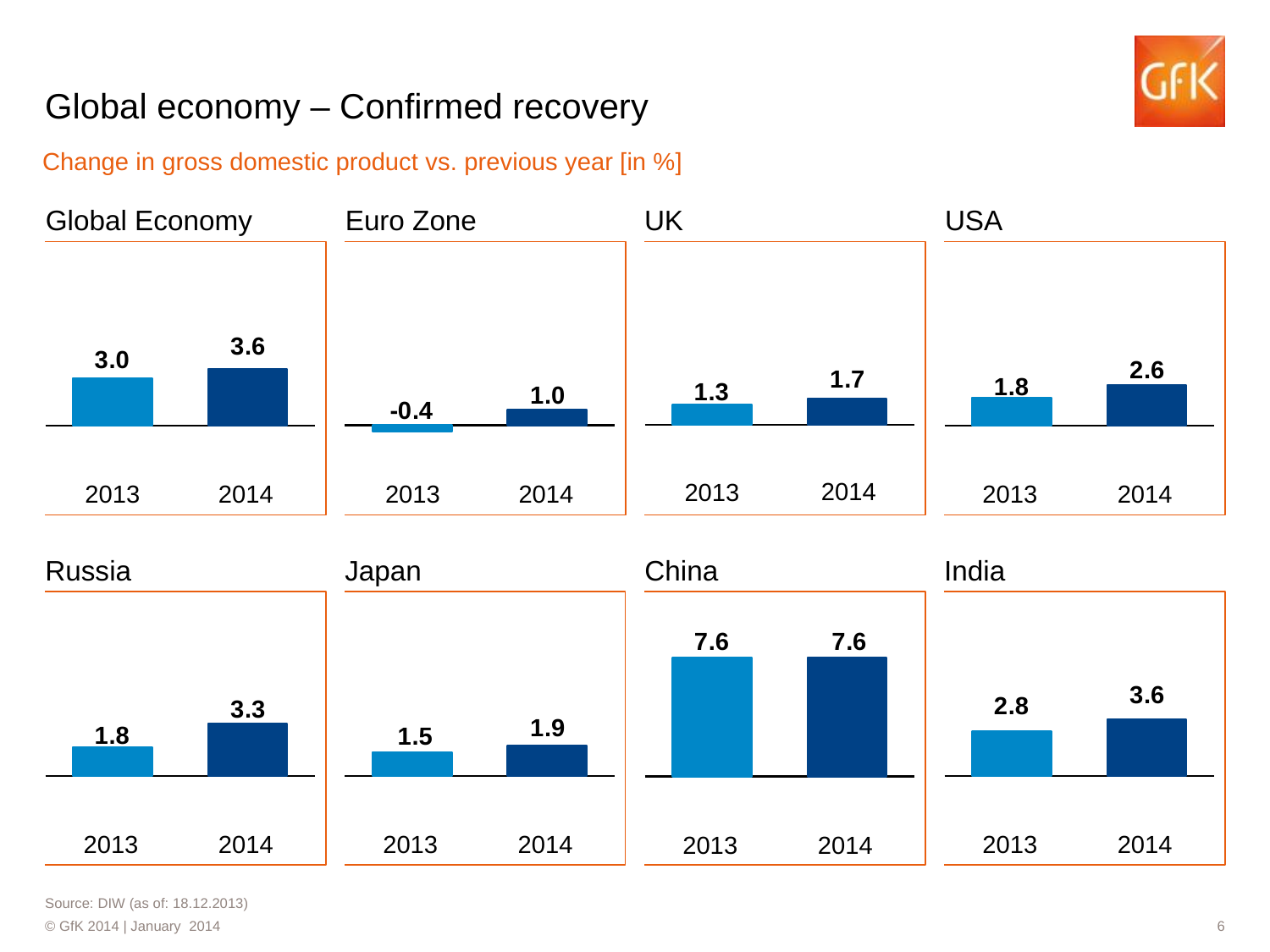
In the Euro Zone chart, do the values rise or fall from 2013 to 2014? rise What kind of chart is the China chart? bar chart What is the subtitle describing the measure shown in the charts? Change in gross domestic product vs. previous year [in %] In the India chart, what is the difference between the 2014 and 2013 values? 0.8 In the USA chart, what is the difference between the 2014 and 2013 values? 0.8 In the Global Economy chart, what is the value for 2014? 3.6 How many bars are shown in the Russia chart? 2 In the Russia chart, which year has the higher value? 2014 In the China chart, what is the value for 2014? 7.6 In the UK chart, what is the value for 2014? 1.7 In the Euro Zone chart, what is the value for 2013? -0.4 In the Japan chart, what is the value for 2013? 1.5